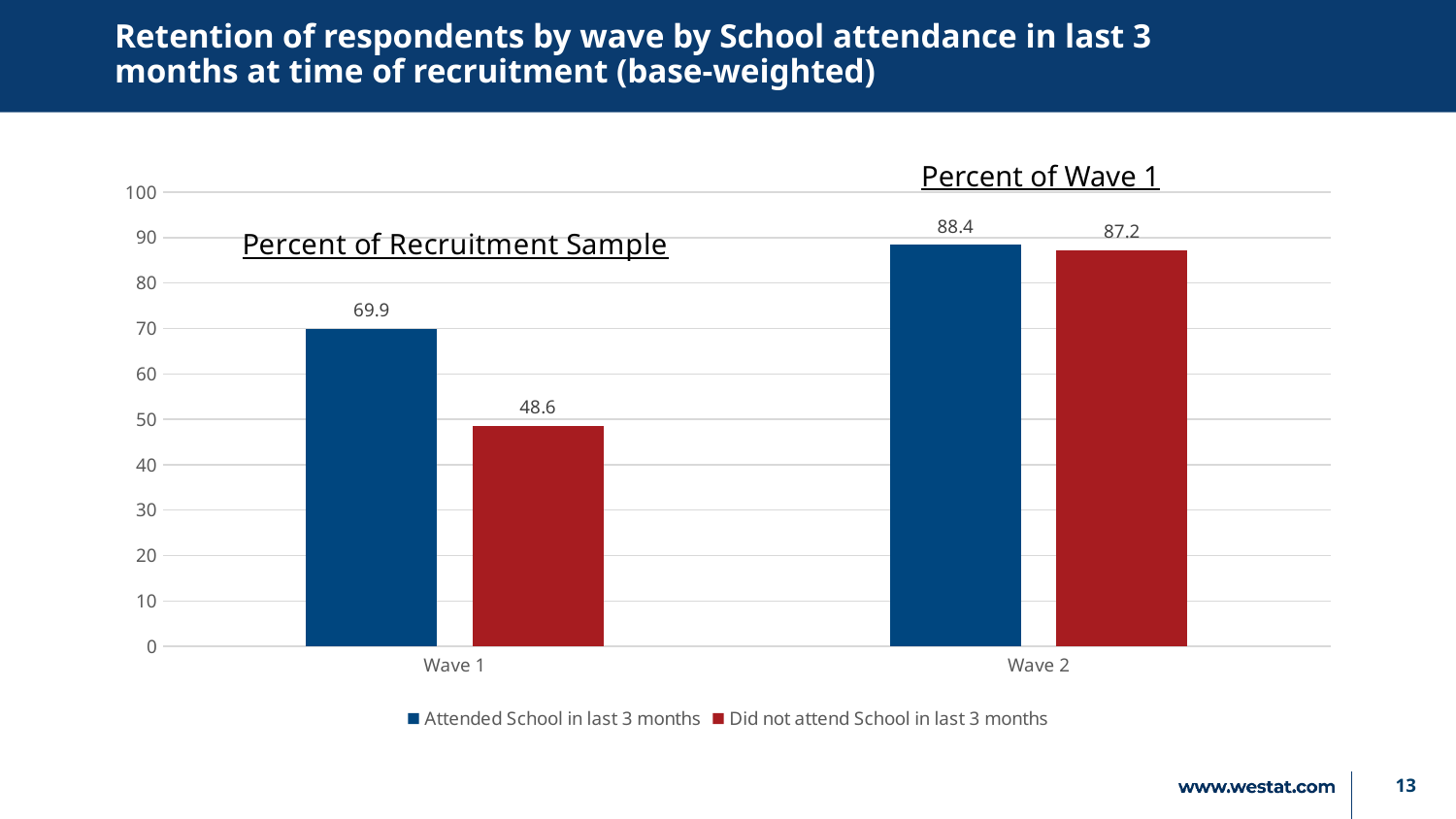
What is the difference between the 'Attended School' and 'Did not attend School' values in Wave 1? 21.3 What is the difference between the 'Attended School' and 'Did not attend School' values in Wave 2? 1.2 How many series does the legend list? 2 What is the value for 'Attended School in last 3 months' in Wave 1? 69.9 What is the value for 'Did not attend School in last 3 months' in Wave 2? 87.2 In Wave 1, which is larger: 'Attended School in last 3 months' or 'Did not attend School in last 3 months'? Attended School in last 3 months What is the value for 'Attended School in last 3 months' in Wave 2? 88.4 Which bar has the highest value on the chart? Attended School in last 3 months, Wave 2 What is the value for 'Did not attend School in last 3 months' in Wave 1? 48.6 What kind of chart is shown on the slide? Bar chart What colour are the bars for 'Did not attend School in last 3 months'? Red Which bar has the lowest value on the chart? Did not attend School in last 3 months, Wave 1